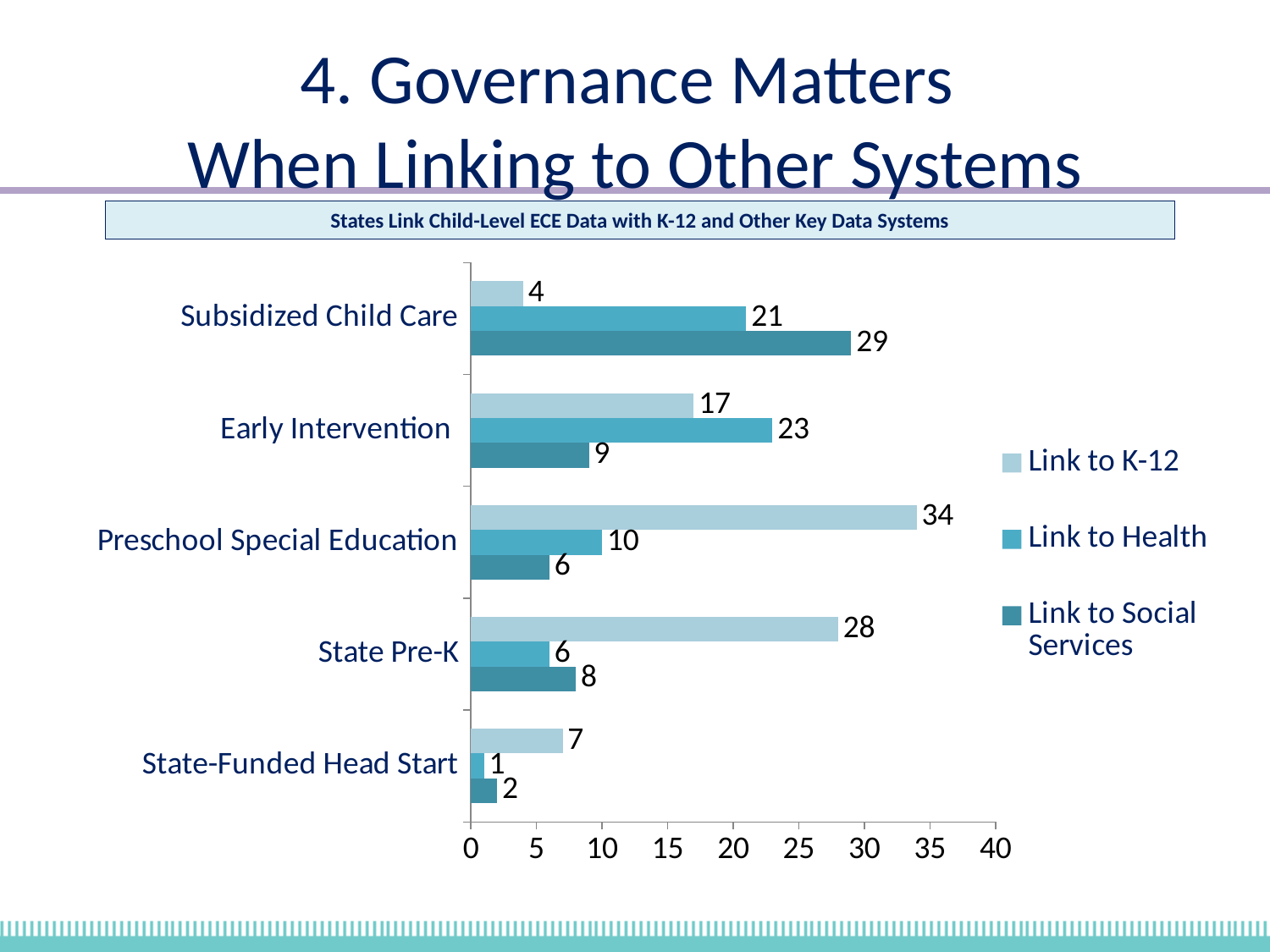
What is the value for Link to K-12 for Preschool Special Education? 34 Which is larger for Early Intervention: Link to K-12 or Link to Health? Link to Health What is the value for Link to Health for Early Intervention? 23 What kind of chart is shown on the slide? bar chart How many categories are shown on the chart? 5 What is the difference between the Link to K-12 value for State Pre-K and the Link to K-12 value for State-Funded Head Start? 21 Is the Link to Health value for Subsidized Child Care greater or less than 20? greater What is the value for Link to Social Services for Subsidized Child Care? 29 What is the title of the chart? States Link Child-Level ECE Data with K-12 and Other Key Data Systems Which category has the lowest Link to Health value? State-Funded Head Start Which category has the highest Link to K-12 value? Preschool Special Education How many series does the legend list? 3